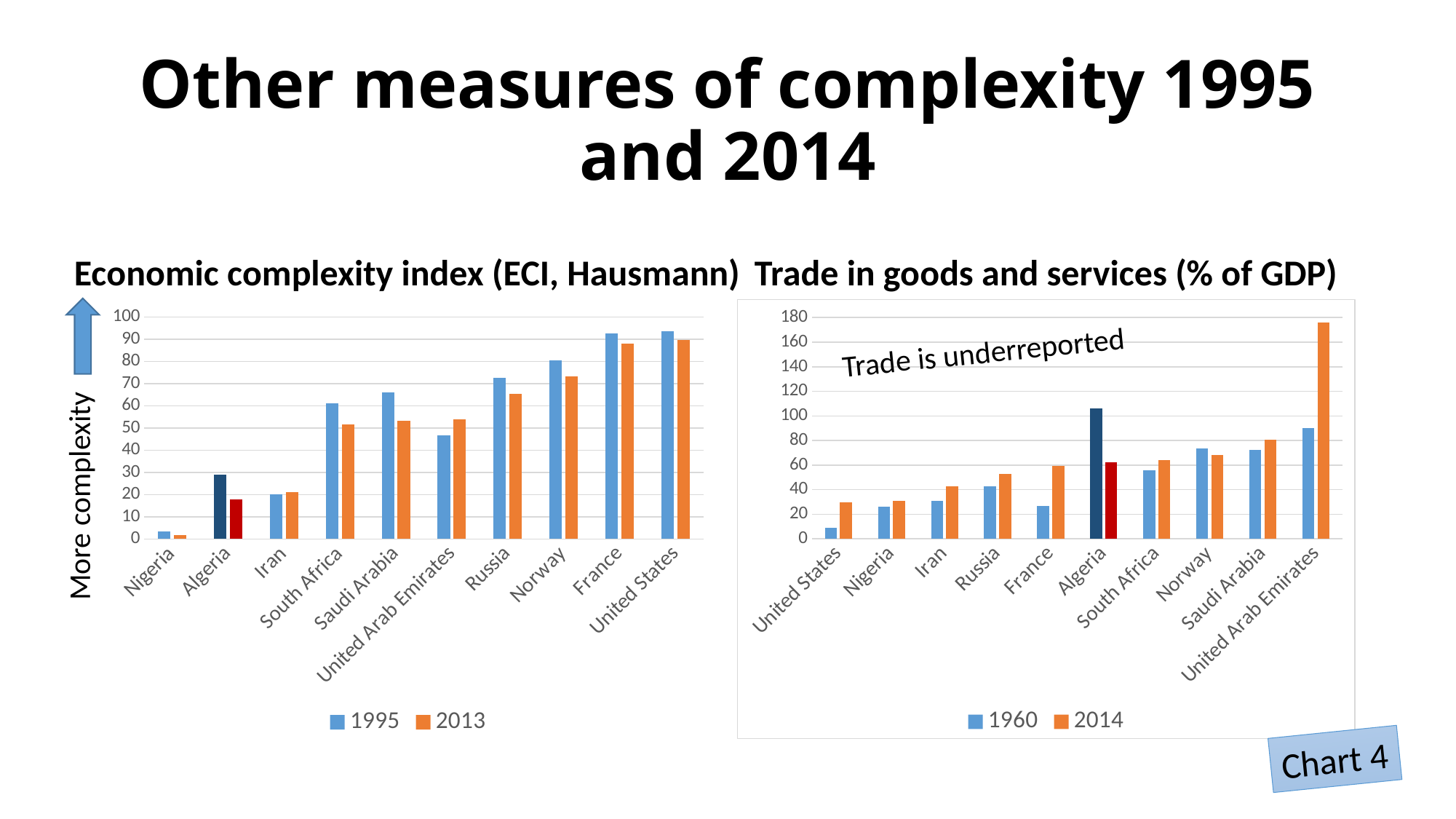
On the 'Economic complexity index (ECI, Hausmann)' chart, which country has the lowest value for 1995? Nigeria What annotation text is written inside the 'Trade in goods and services (% of GDP)' chart? Trade is underreported On the 'Economic complexity index (ECI, Hausmann)' chart, which is larger for South Africa, the 1995 value or the 2013 value? 1995 How many countries are shown on the 'Trade in goods and services (% of GDP)' chart? 10 On the 'Trade in goods and services (% of GDP)' chart, is the 1960 value for Algeria greater or less than 100? greater On the 'Economic complexity index (ECI, Hausmann)' chart, is the 2013 value for United Arab Emirates greater or less than 50? greater What kind of chart is the 'Economic complexity index (ECI, Hausmann)' chart? bar chart On the 'Trade in goods and services (% of GDP)' chart, which country has the lowest value for 1960? United States How many series does the legend of the 'Economic complexity index (ECI, Hausmann)' chart list? 2 On the 'Economic complexity index (ECI, Hausmann)' chart, is the 1995 value for South Africa greater or less than 50? greater On the 'Trade in goods and services (% of GDP)' chart, which country has the highest value for 2014? United Arab Emirates